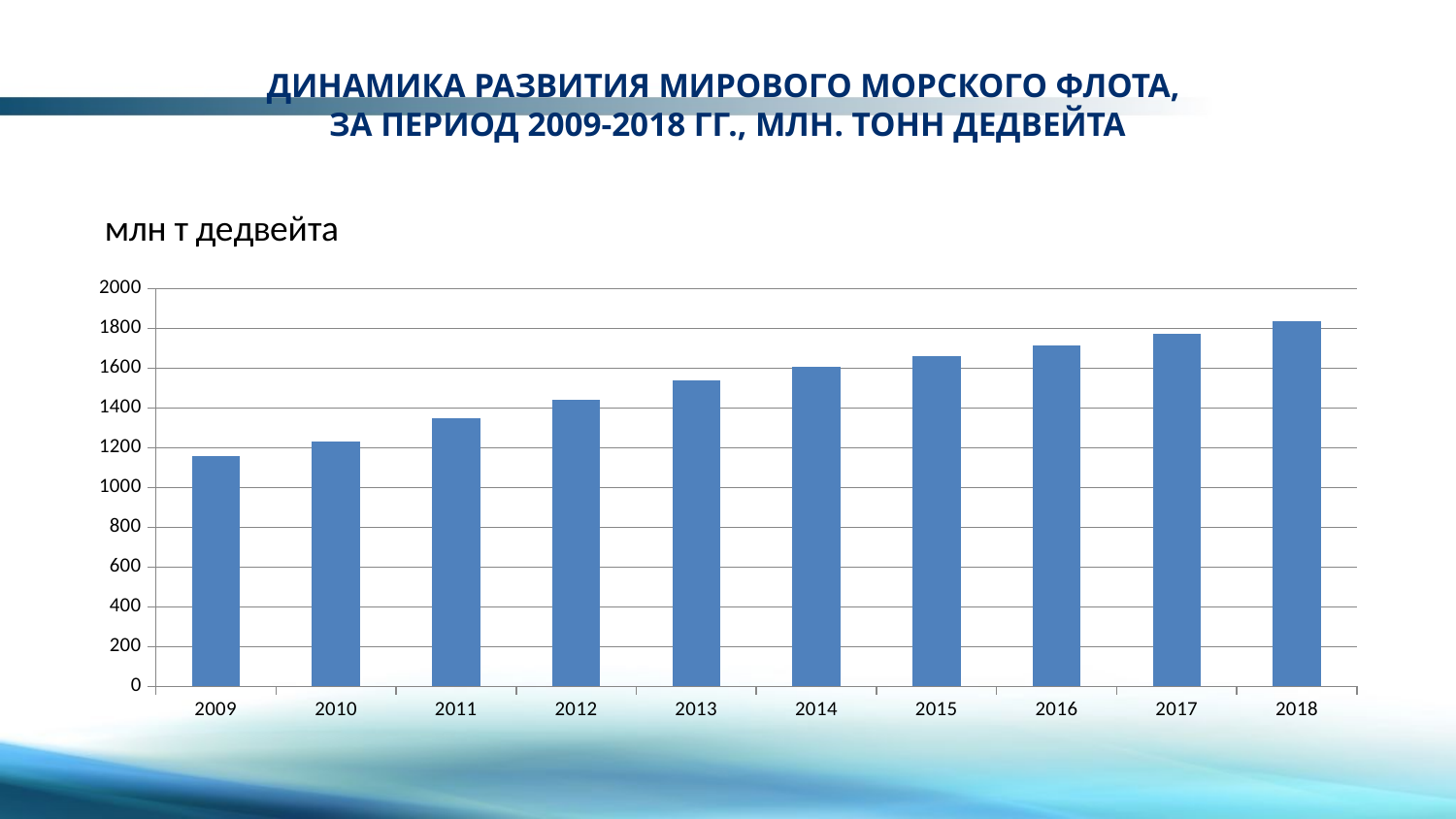
What is the highest tick value shown on the vertical axis? 2000 Is the value for 2013 greater or less than 1600? less What unit label is shown above the chart? млн т дедвейта Is the value for 2009 greater or less than 1200? less Is the value for 2011 greater or less than 1200? greater What kind of chart is shown on the slide? bar chart Which is larger, the value for 2012 or the value for 2016? 2016 How many years are plotted on the x axis of the chart? 10 Do the values rise or fall from 2009 to 2018? rise Which year has the highest value in the chart? 2018 Which year has the lowest value in the chart? 2009